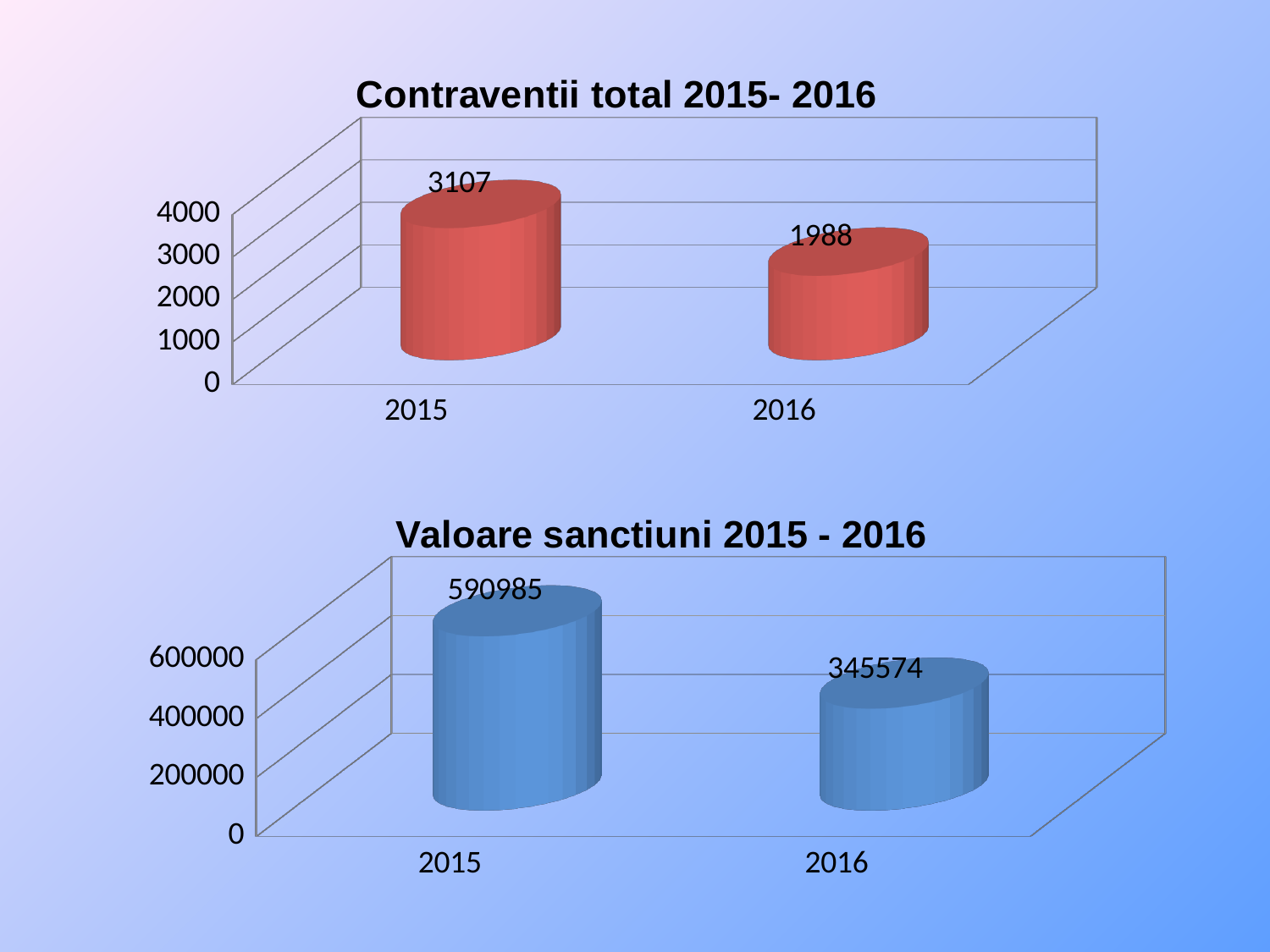
In the 'Contraventii total 2015- 2016' chart, what is the value for 2016? 1988 In the 'Valoare sanctiuni 2015 - 2016' chart, what is the value for 2015? 590985 In the 'Valoare sanctiuni 2015 - 2016' chart, which year has the lower value? 2016 In the 'Contraventii total 2015- 2016' chart, which year has the higher value? 2015 In the 'Contraventii total 2015- 2016' chart, what is the value for 2015? 3107 What kind of chart is the 'Valoare sanctiuni 2015 - 2016' chart? bar chart In the 'Contraventii total 2015- 2016' chart, do the values rise or fall from 2015 to 2016? fall How many categories are shown in the 'Contraventii total 2015- 2016' chart? 2 In the 'Contraventii total 2015- 2016' chart, what is the difference between the 2015 and 2016 values? 1119 In the 'Valoare sanctiuni 2015 - 2016' chart, is the value for 2016 greater or less than 400000? less In the 'Valoare sanctiuni 2015 - 2016' chart, what is the value for 2016? 345574 In the 'Valoare sanctiuni 2015 - 2016' chart, what is the difference between the 2015 and 2016 values? 245411